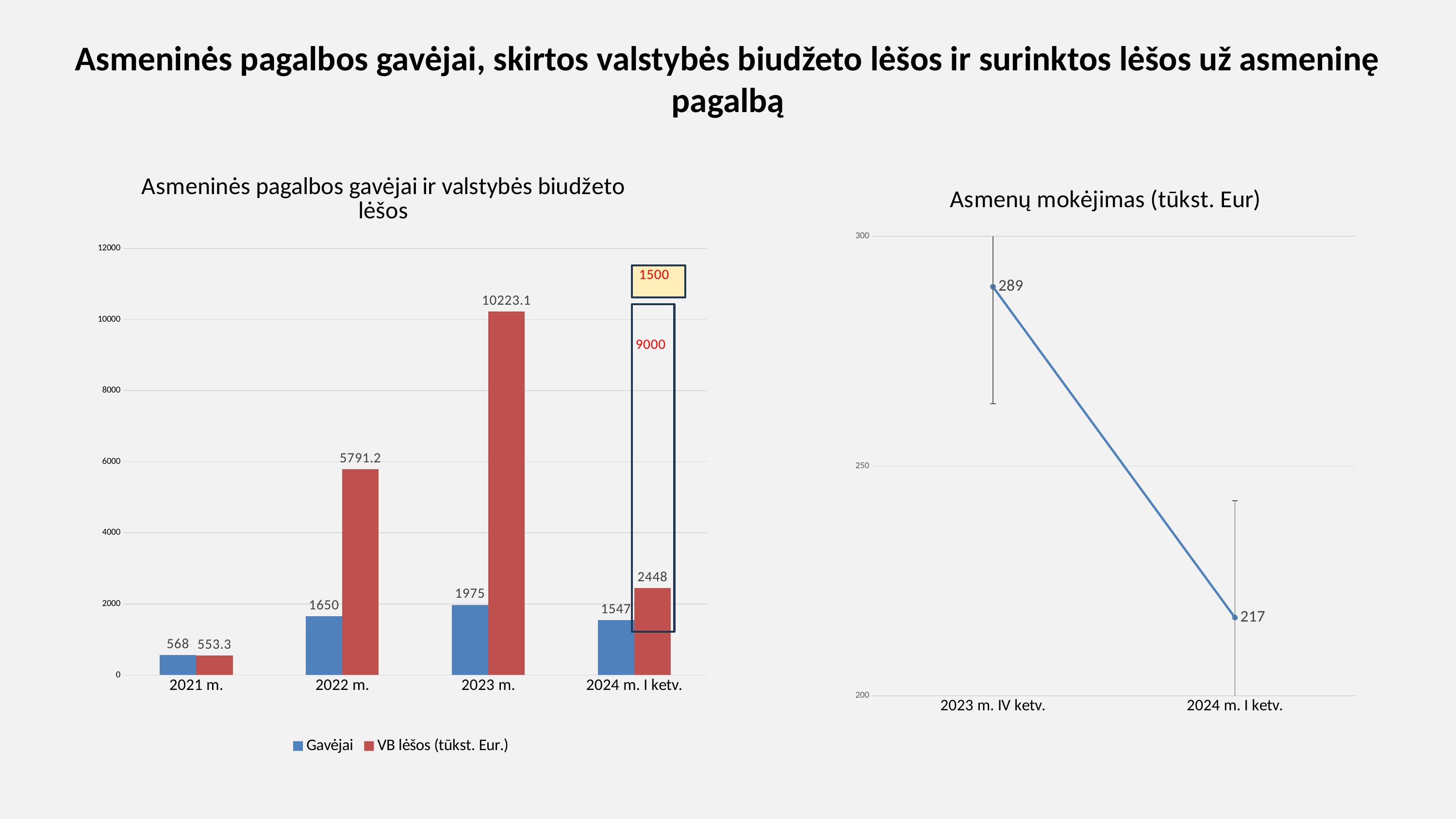
In the chart 'Asmeninės pagalbos gavėjai ir valstybės biudžeto lėšos', what is the difference between the Gavėjai values for 2023 m. and 2024 m. I ketv.? 428 In the chart 'Asmeninės pagalbos gavėjai ir valstybės biudžeto lėšos', what is the value of Gavėjai for 2022 m.? 1650 In the chart 'Asmeninės pagalbos gavėjai ir valstybės biudžeto lėšos', which is larger for 2024 m. I ketv.: Gavėjai or VB lėšos (tūkst. Eur.)? VB lėšos (tūkst. Eur.) In the chart 'Asmenų mokėjimas (tūkst. Eur)', what is the value for 2024 m. I ketv.? 217 In the chart 'Asmeninės pagalbos gavėjai ir valstybės biudžeto lėšos', which category has the lowest value of VB lėšos (tūkst. Eur.)? 2021 m. What kind of chart is 'Asmenų mokėjimas (tūkst. Eur)'? line chart How many categories are shown on the x axis of the chart 'Asmeninės pagalbos gavėjai ir valstybės biudžeto lėšos'? 4 In the chart 'Asmeninės pagalbos gavėjai ir valstybės biudžeto lėšos', what is the value of VB lėšos (tūkst. Eur.) for 2023 m.? 10223.1 In the chart 'Asmeninės pagalbos gavėjai ir valstybės biudžeto lėšos', which category has the highest value of Gavėjai? 2023 m. In the chart 'Asmenų mokėjimas (tūkst. Eur)', what is the difference between the values for 2023 m. IV ketv. and 2024 m. I ketv.? 72 How many series does the legend of the chart 'Asmeninės pagalbos gavėjai ir valstybės biudžeto lėšos' list? 2 In the chart 'Asmeninės pagalbos gavėjai ir valstybės biudžeto lėšos', what is the value of VB lėšos (tūkst. Eur.) for 2021 m.? 553.3